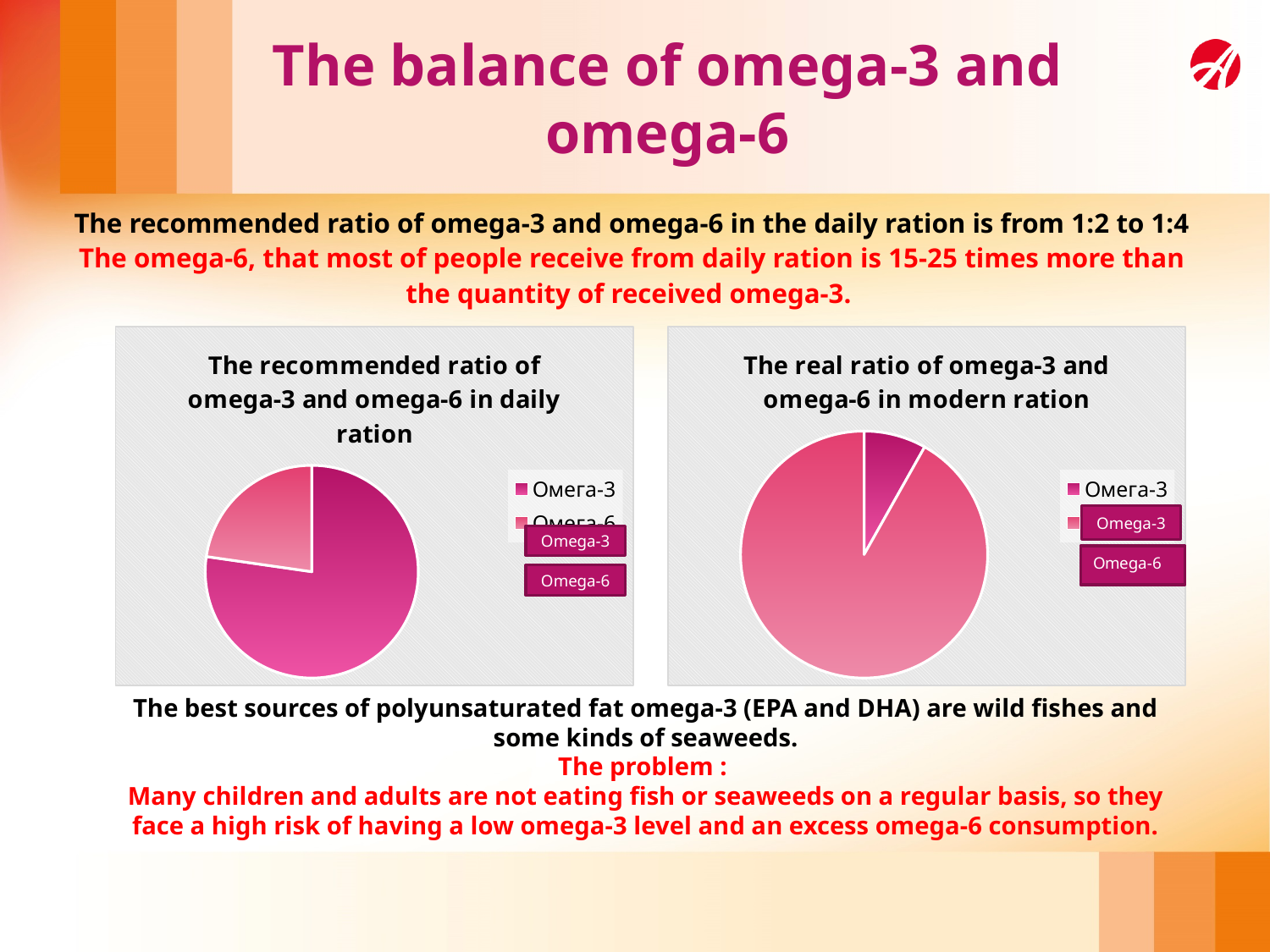
In the right chart, 'The real ratio of omega-3 and omega-6 in modern ration', which slice is the largest? Omega-6 In the right chart, 'The real ratio of omega-3 and omega-6 in modern ration', which slice is the smallest? Omega-3 How many slices does the left pie chart, 'The recommended ratio of omega-3 and omega-6 in daily ration', have? 2 How many slices does the right pie chart, 'The real ratio of omega-3 and omega-6 in modern ration', have? 2 How many entries does the legend of the right chart, 'The real ratio of omega-3 and omega-6 in modern ration', list? 2 How many entries does the legend of the left chart, 'The recommended ratio of omega-3 and omega-6 in daily ration', list? 2 What is the title of the left pie chart on the slide? The recommended ratio of omega-3 and omega-6 in daily ration What kind of chart is the right chart, 'The real ratio of omega-3 and omega-6 in modern ration'? Pie chart What kind of chart is the left chart, 'The recommended ratio of omega-3 and omega-6 in daily ration'? Pie chart In the right chart, 'The real ratio of omega-3 and omega-6 in modern ration', which is larger, the Omega-3 slice or the Omega-6 slice? Omega-6 What is the title of the right pie chart on the slide? The real ratio of omega-3 and omega-6 in modern ration